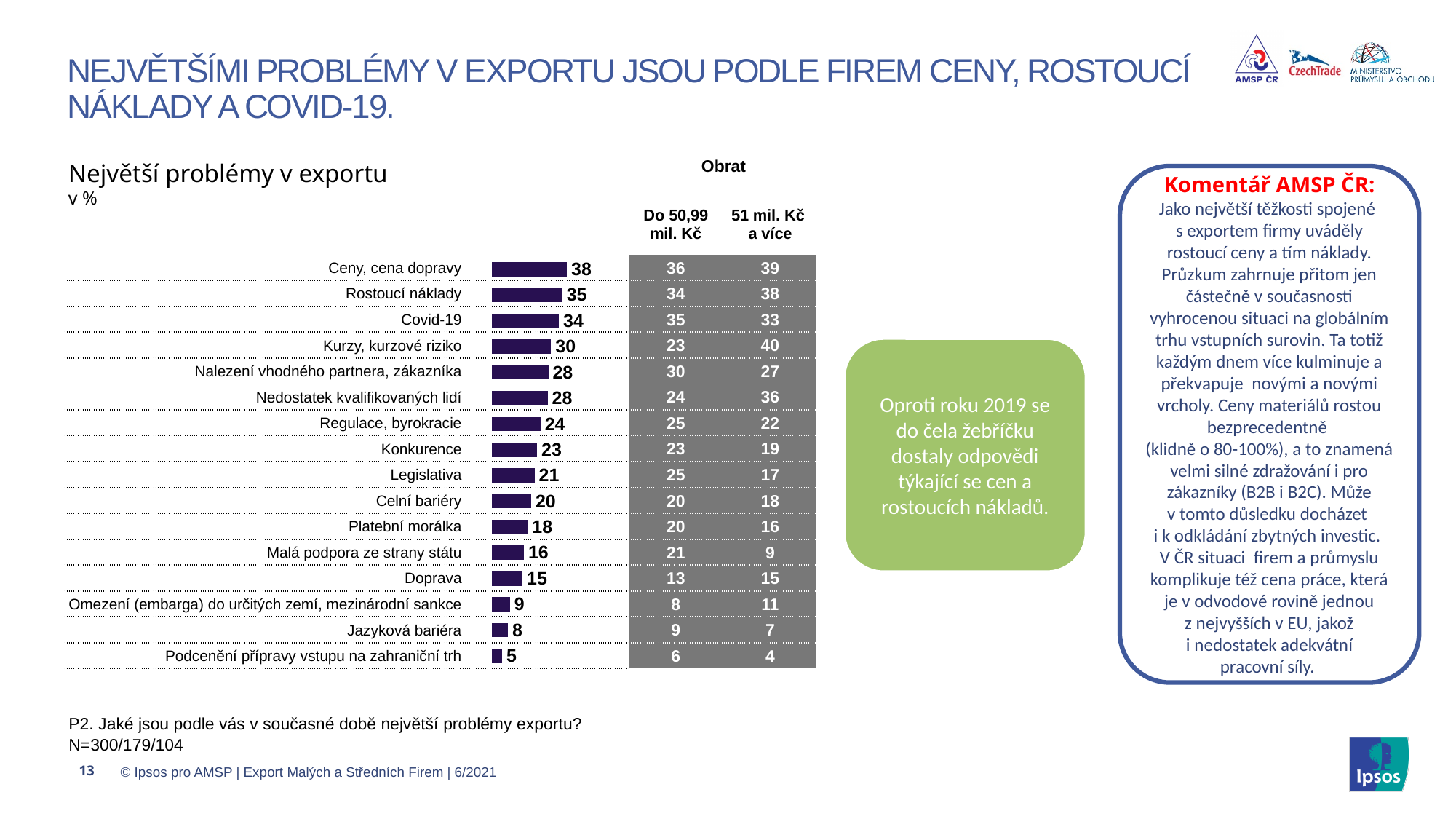
What is the value for "Platební morálka" in the bar chart? 18 What kind of chart is used to show the largest export problems? Bar chart What is the difference between the values for "Covid-19" and "Jazyková bariéra" in the bar chart? 26 What is the title of the bar chart? Největší problémy v exportu What is the difference between the values for "Rostoucí nákladky" (Rostoucí náklady) and "Doprava" in the bar chart? 20 What is the value for "Ceny, cena dopravy" in the bar chart? 38 How many categories are shown in the bar chart? 16 In what unit are the values in the bar chart expressed, according to the subtitle? v % Which is larger in the bar chart: the value for "Konkurence" or the value for "Legislativa"? Konkurence What is the value for "Kurzy, kurzové riziko" in the bar chart? 30 Which category has the lowest value in the bar chart? Podcenění přípravy vstupu na zahraniční trh Which category has the highest value in the bar chart? Ceny, cena dopravy